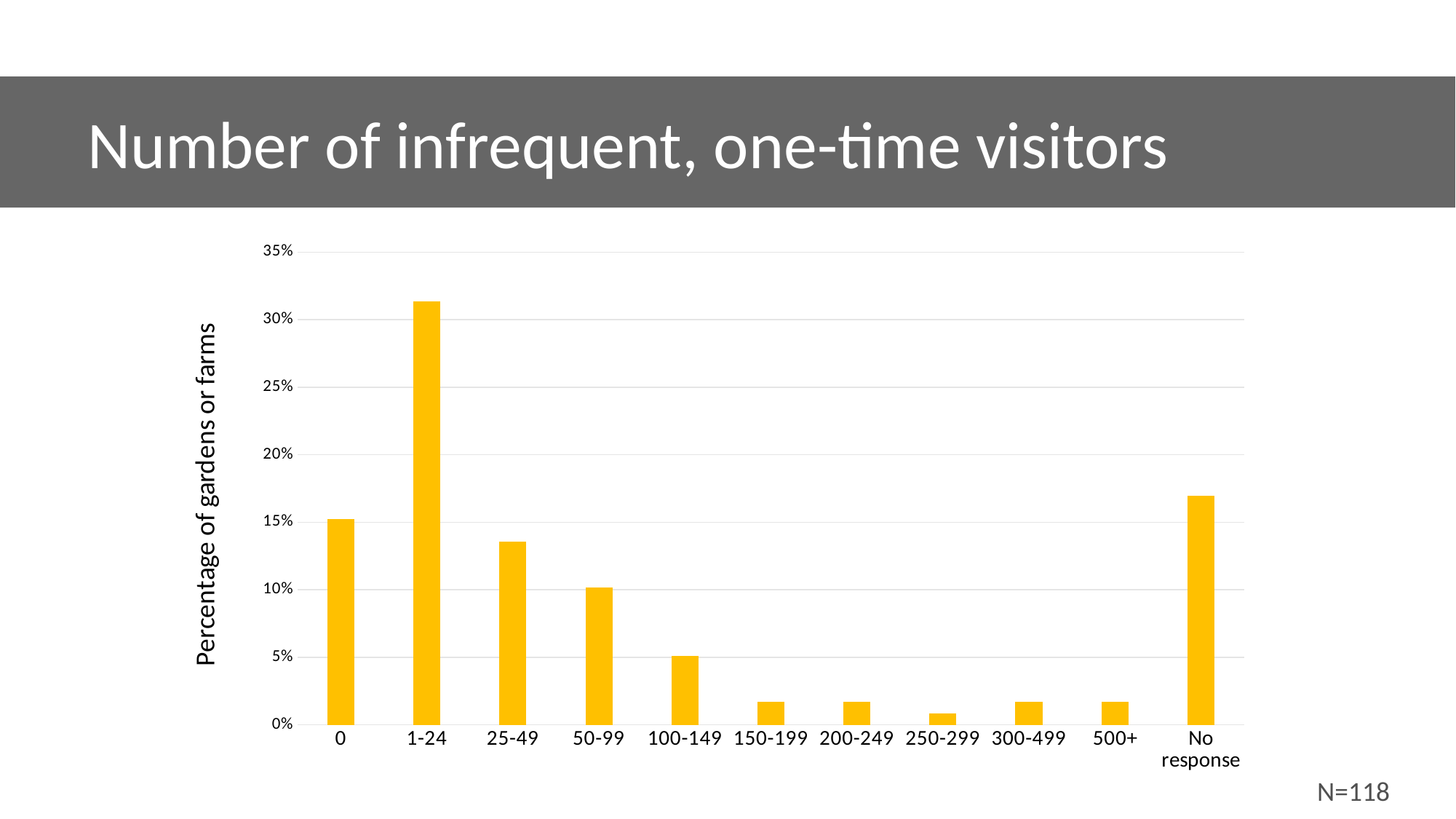
Which category has the highest percentage of gardens or farms? 1-24 How many categories are shown on the x axis? 11 What is the label of the vertical axis? Percentage of gardens or farms Is the value for 25-49 greater or less than 15%? less Is the value for No response greater or less than 15%? greater Is the value for 100-149 greater or less than 10%? less Which category has the lowest percentage of gardens or farms? 250-299 What kind of chart is shown on the slide? bar chart Which is larger, the value for No response or the value for 0? No response Which is larger, the value for 25-49 or the value for 50-99? 25-49